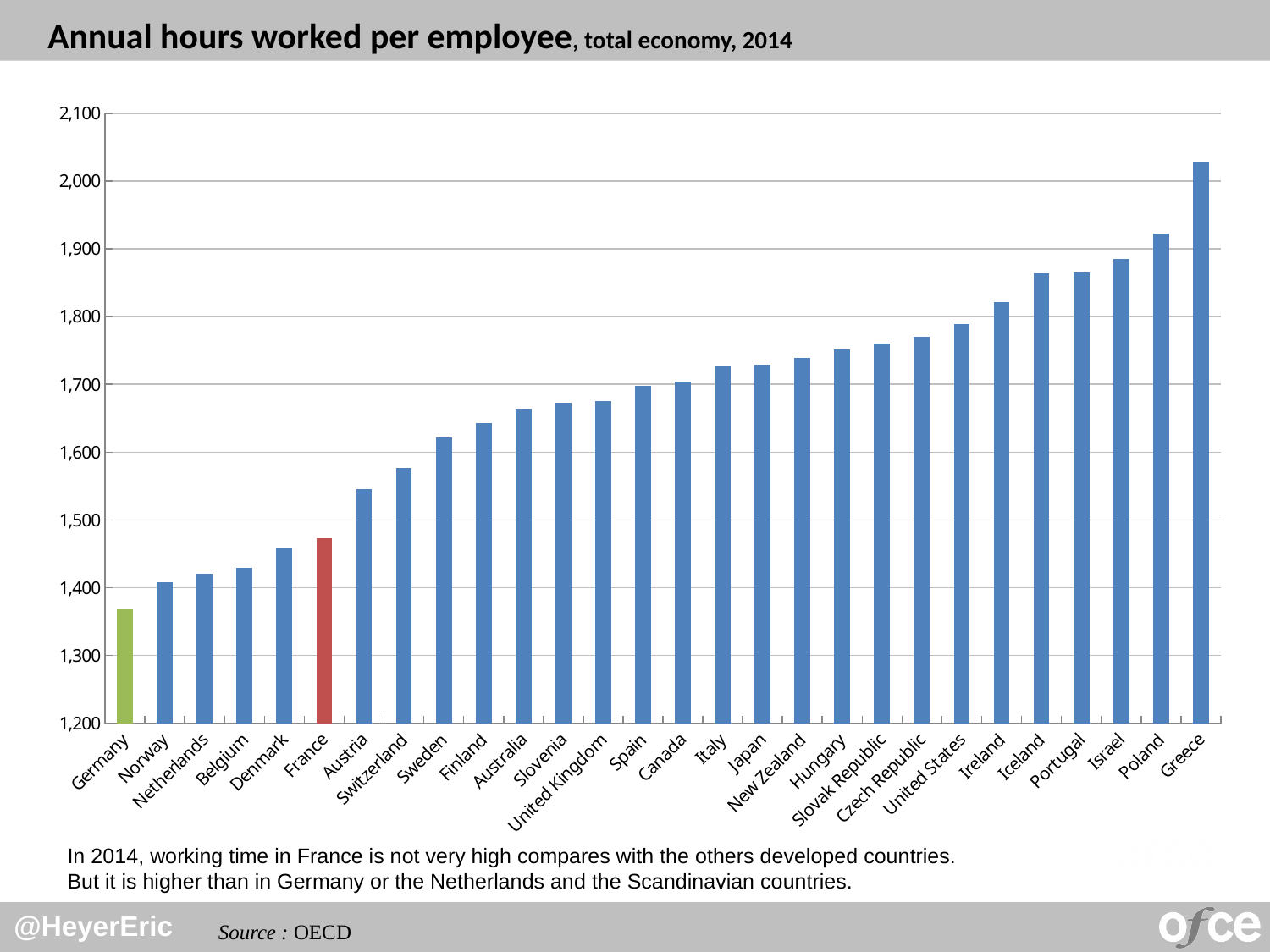
Which country has the lowest annual hours worked per employee? Germany What kind of chart is shown on the slide? bar chart Which has more annual hours worked per employee, France or the Netherlands? France Is the value for Germany greater or less than 1,400? less Which country's bar is coloured red? France Is the value for the United States greater or less than 1,800? less How many countries are shown on the chart? 28 Is the value for France greater or less than 1,500? less Do the values generally rise or fall from left to right along the x axis? rise Which country has the highest annual hours worked per employee? Greece